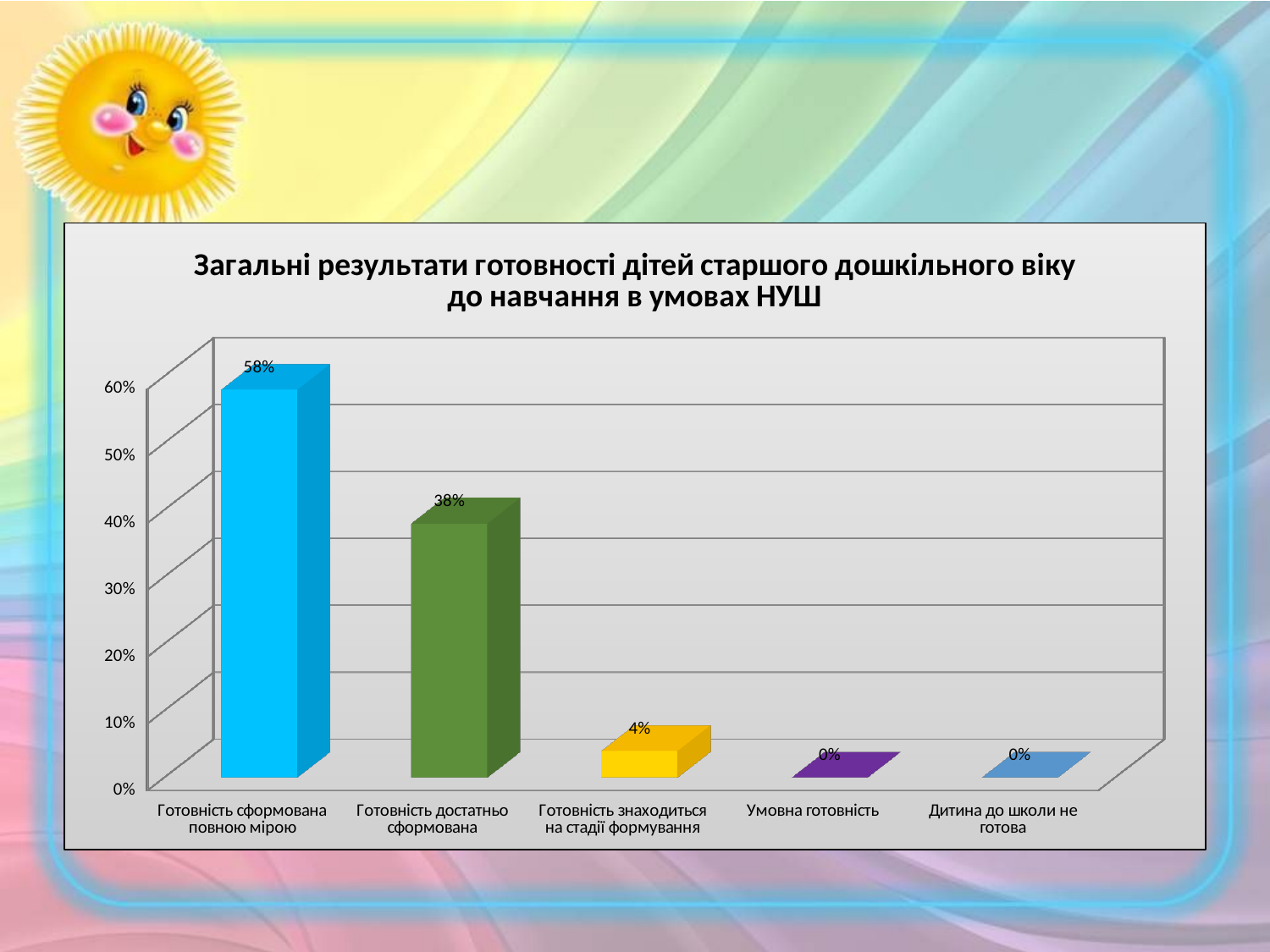
What is the value for "Готовність сформована повною мірою"? 58% What kind of chart is shown on the slide? bar chart What is the value for "Готовність знаходиться на стадії формування"? 4% Which is larger, the value for "Готовність достатньо сформована" or the value for "Готовність знаходиться на стадії формування"? Готовність достатньо сформована How many categories are shown on the x axis? 5 Which category has the highest value? Готовність сформована повною мірою Do the values rise or fall from left to right along the x axis? fall What is the title of the chart? Загальні результати готовності дітей старшого дошкільного віку до навчання в умовах НУШ Is the value for "Готовність достатньо сформована" greater or less than 30%? greater What is the value for "Умовна готовність"? 0% What is the value for "Готовність достатньо сформована"? 38% What is the difference between the values for "Готовність сформована повною мірою" and "Готовність достатньо сформована"? 20%